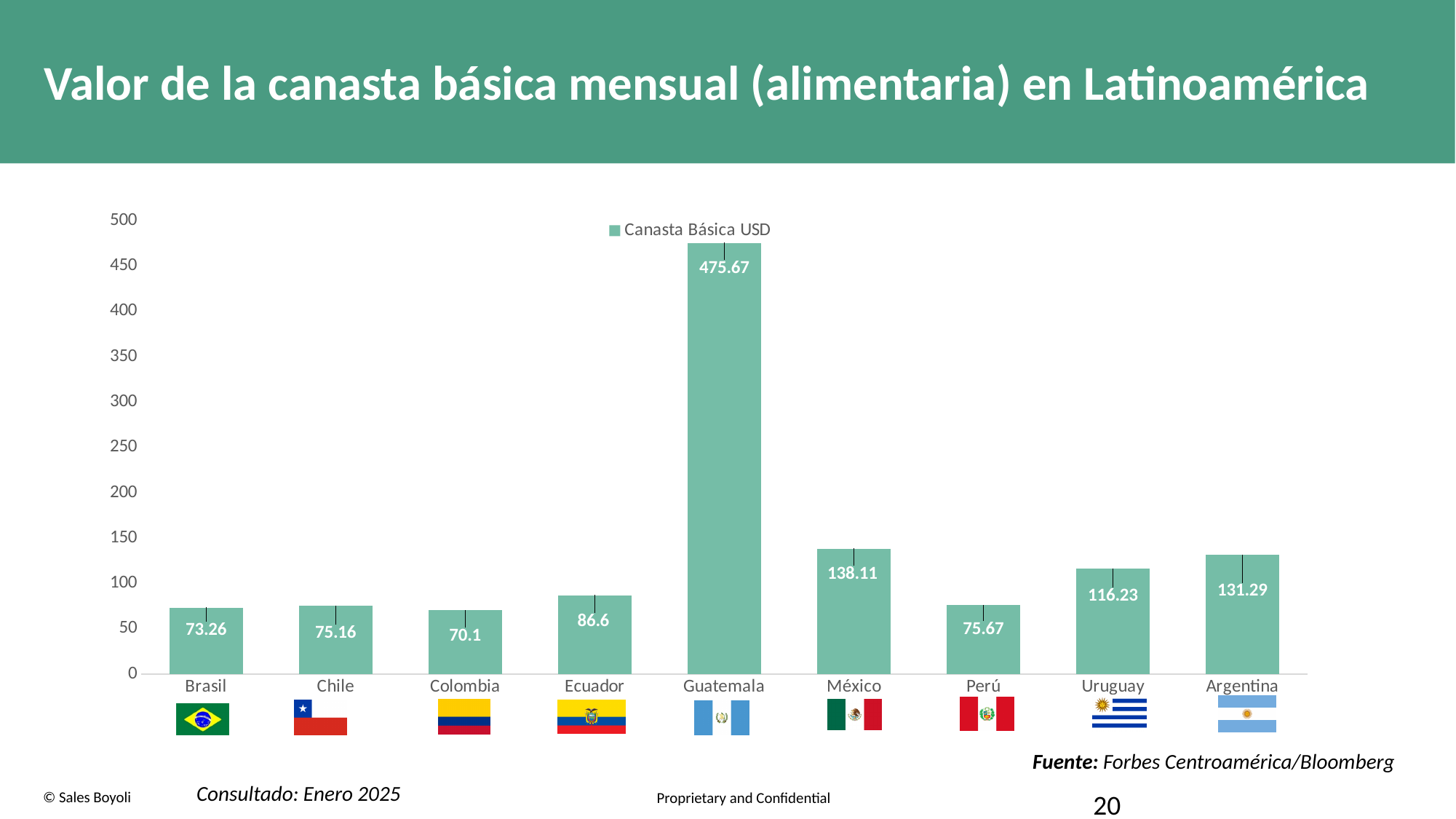
What is the value for México? 138.11 Which country has the lowest value? Colombia Which is larger, the value for Ecuador or the value for Chile? Ecuador What kind of chart is shown? bar chart What is the legend entry for the series? Canasta Básica USD Which country has the highest value? Guatemala What is the value for Colombia? 70.1 What is the value for Guatemala? 475.67 How many countries are shown on the chart? 9 Is the value for Perú greater or less than 100? less How many series does the legend list? 1 What is the difference between the values for Argentina and Uruguay? 15.06